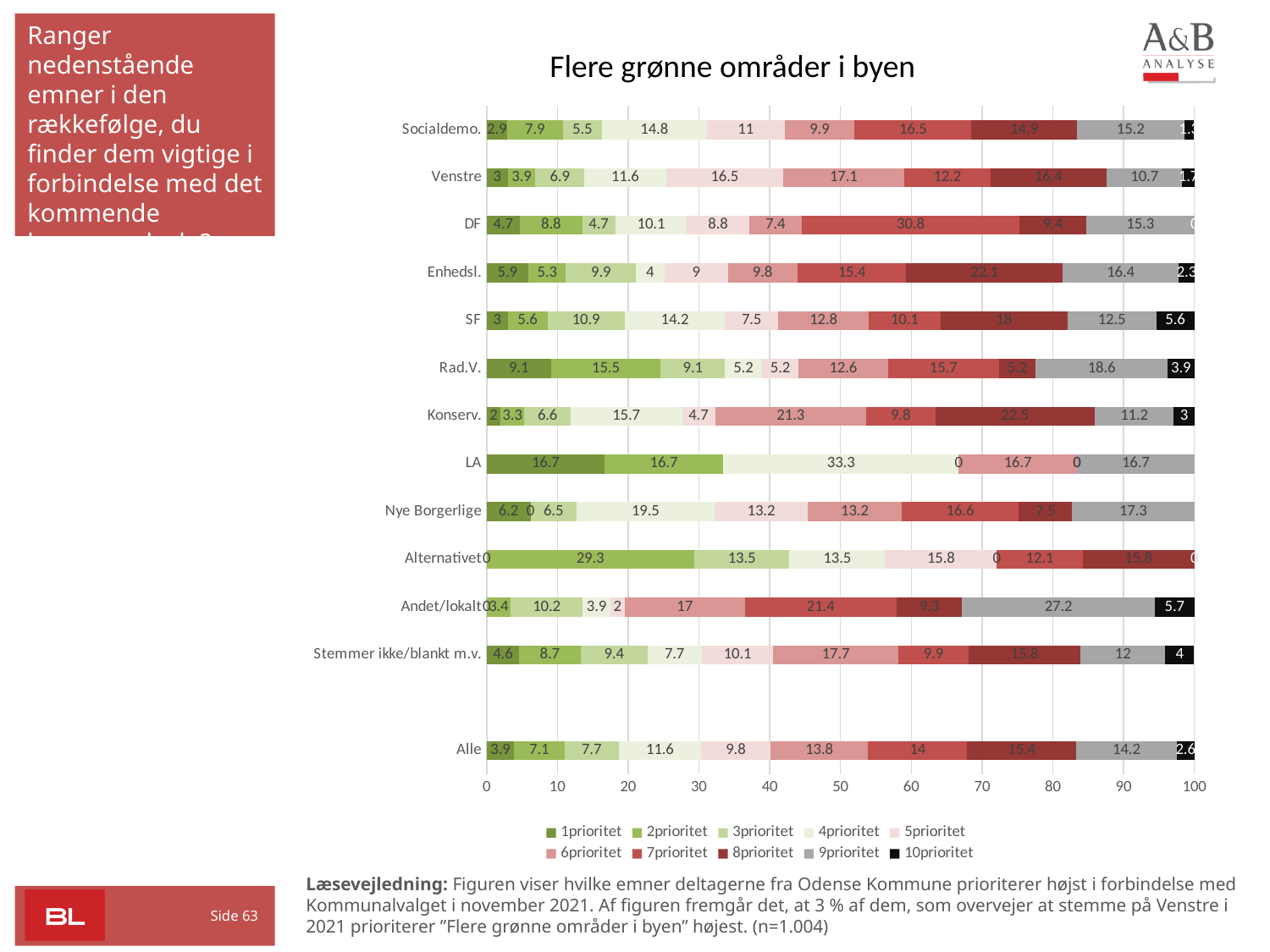
What is the 1prioritet value for Venstre? 3 Which category has the highest 7prioritet value? DF How many categories (rows) are plotted on the chart? 13 For Alle, what is the difference between the 2prioritet value and the 1prioritet value? 3.2 What is the 7prioritet value for DF? 30.8 What kind of chart is shown on the slide? bar chart Which has the larger 9prioritet value, Andet/lokalt or Rad.V.? Andet/lokalt Which category has the highest 1prioritet value? LA How many series does the legend list? 10 What is the 8prioritet value for Konserv.? 22.5 What is the 2prioritet value for Alternativet? 29.3 What is the 10prioritet value for SF? 5.6